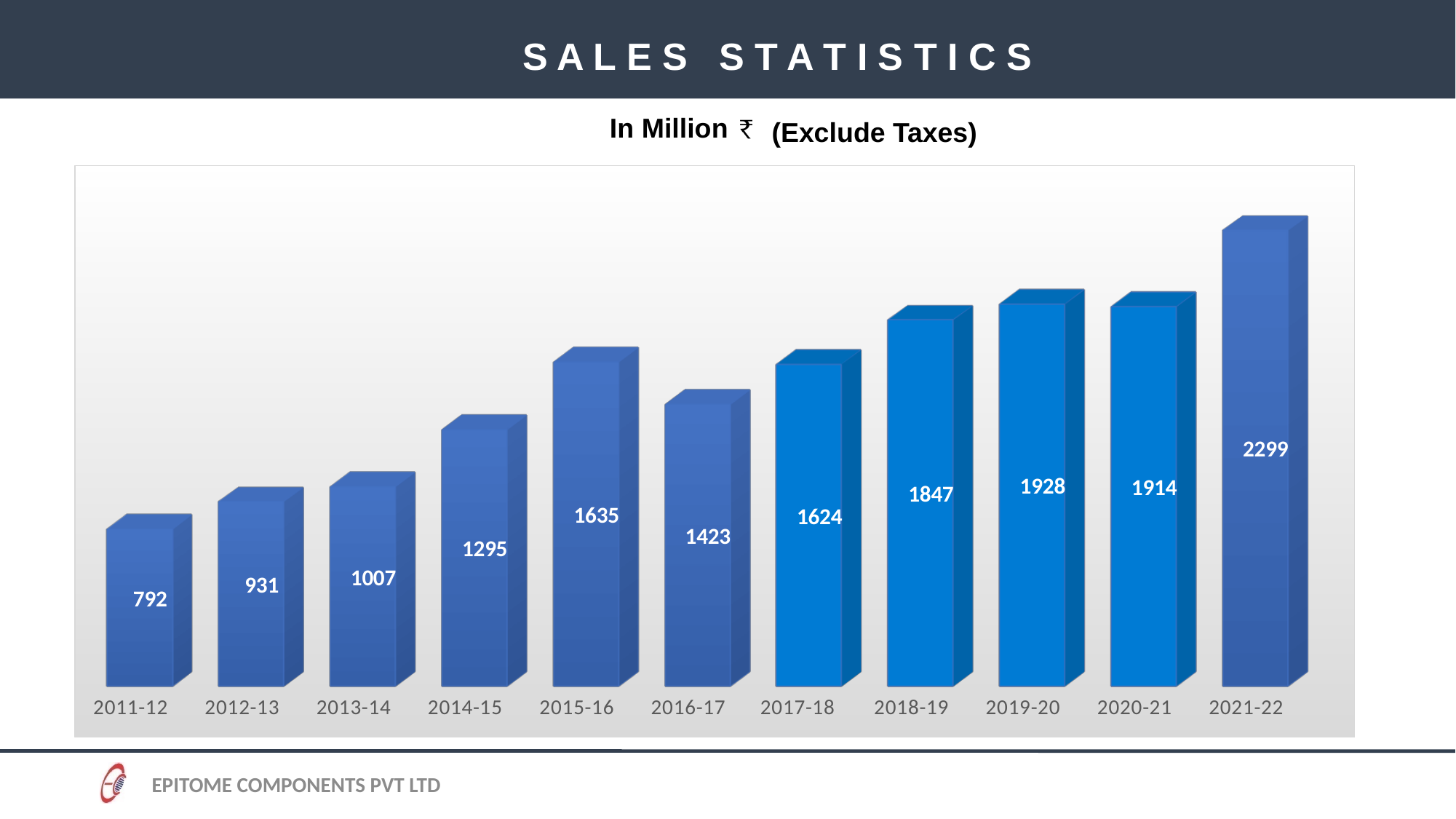
Which year has the highest sales value? 2021-22 How many years are shown on the chart? 11 What is the sales value for 2017-18? 1624 Which year has the lowest sales value? 2011-12 What is the sales value for 2011-12? 792 What kind of chart is shown on the slide? Bar chart Which is larger, the sales value for 2019-20 or for 2018-19? 2019-20 Do the sales values generally rise or fall from 2011-12 to 2021-22? Rise What is the sales value for 2020-21? 1914 What is the difference between the sales values for 2021-22 and 2020-21? 385 In what unit are the sales values shown, according to the subtitle? In Million ₹ (Exclude Taxes) What is the difference between the sales values for 2015-16 and 2016-17? 212